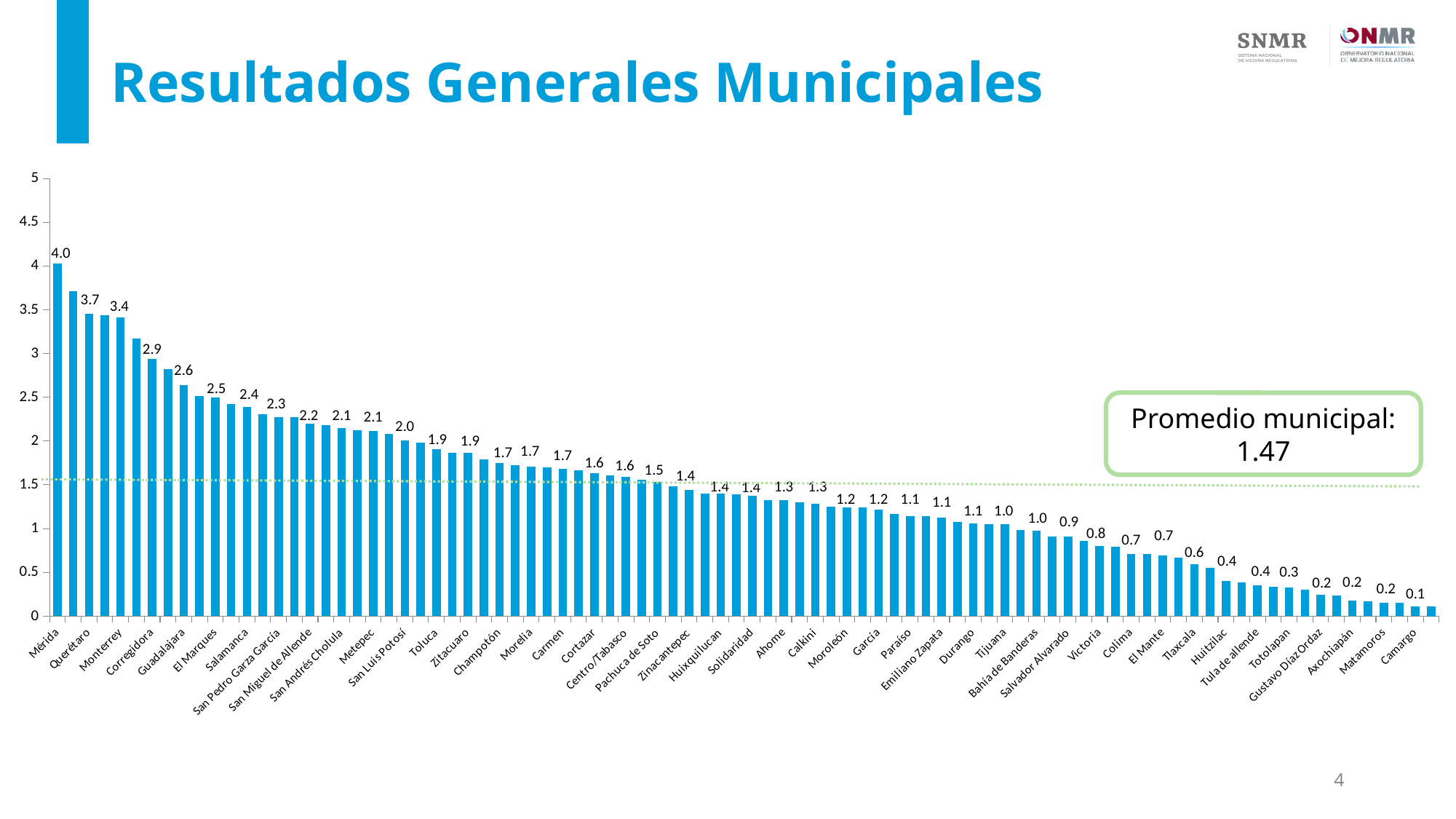
Which municipality has the highest value in the chart? Mérida What is the difference between the values for Mérida and Camargo? 3.9 Do the values rise or fall from left to right along the x axis? fall Is the value for Monterrey greater or less than 3? greater What kind of chart is shown on the slide? bar chart What is the value for Camargo? 0.1 Is the value for Matamoros greater or less than 0.5? less Is the value for Tijuana greater or less than 1.5? less Which has a larger value, Querétaro or Tlaxcala? Querétaro What is the value for Mérida? 4.0 What is the municipal average (Promedio municipal) shown on the slide? 1.47